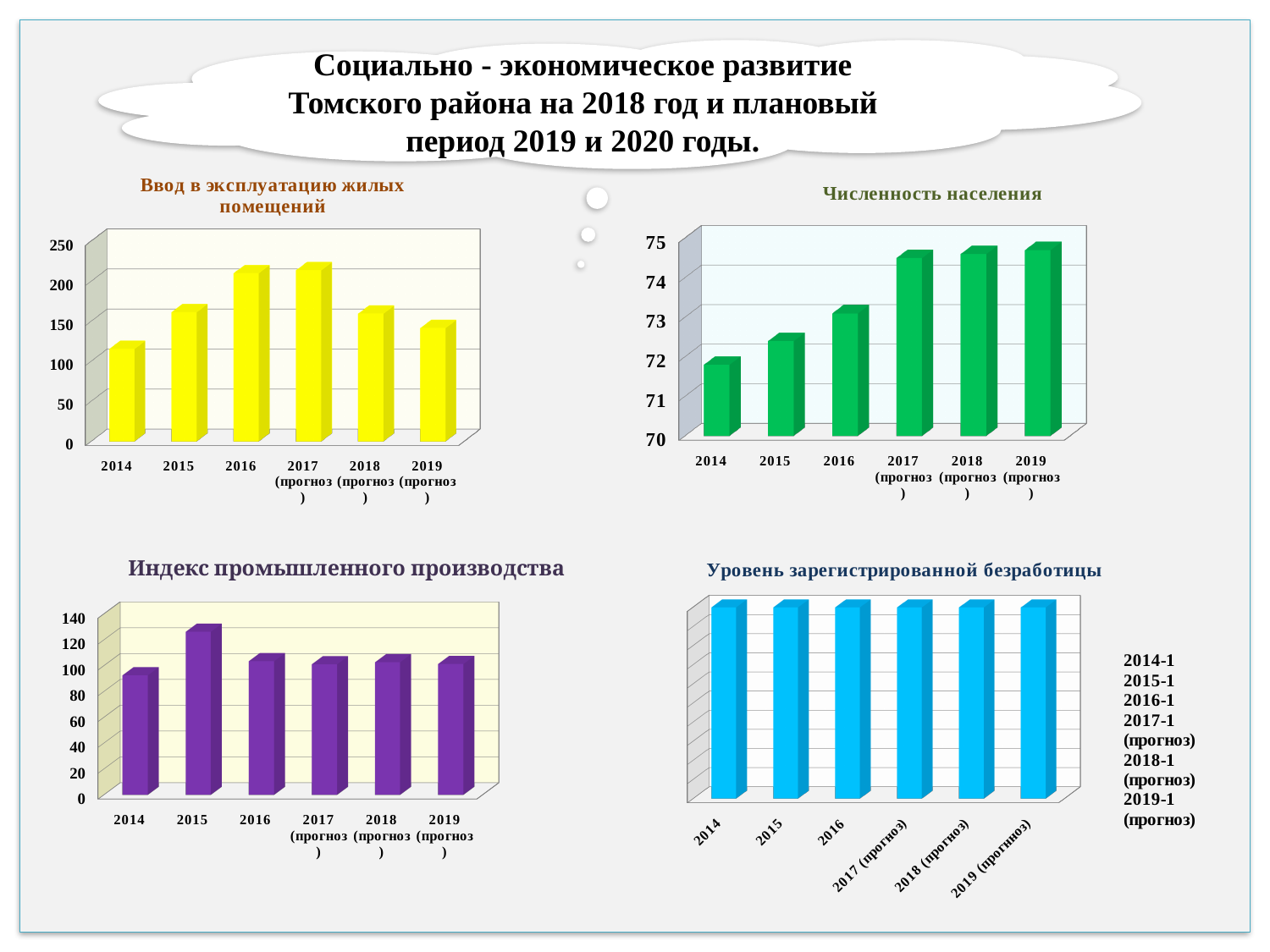
In the chart titled "Индекс промышленного производства", which year has the highest value? 2015 In the chart titled "Численность населения", which is larger, the value for 2016 or the value for 2015? 2016 In the chart titled "Ввод в эксплуатацию жилых помещений", is the value for 2016 greater or less than 200? greater In the chart titled "Численность населения", is the value for 2017 (прогноз) greater or less than 74? greater In the chart titled "Численность населения", do the values generally rise or fall from 2014 to 2019 (прогноз)? rise In the chart titled "Ввод в эксплуатацию жилых помещений", which year has the lowest value? 2014 In the chart titled "Ввод в эксплуатацию жилых помещений", how many years are shown on the x axis? 6 In the chart titled "Уровень зарегистрированной безработицы", how many bars are plotted? 6 In the chart titled "Индекс промышленного производства", is the value for 2014 greater or less than 100? less In the chart titled "Численность населения", which year has the lowest value? 2014 What kind of chart is the chart titled "Уровень зарегистрированной безработицы"? bar chart